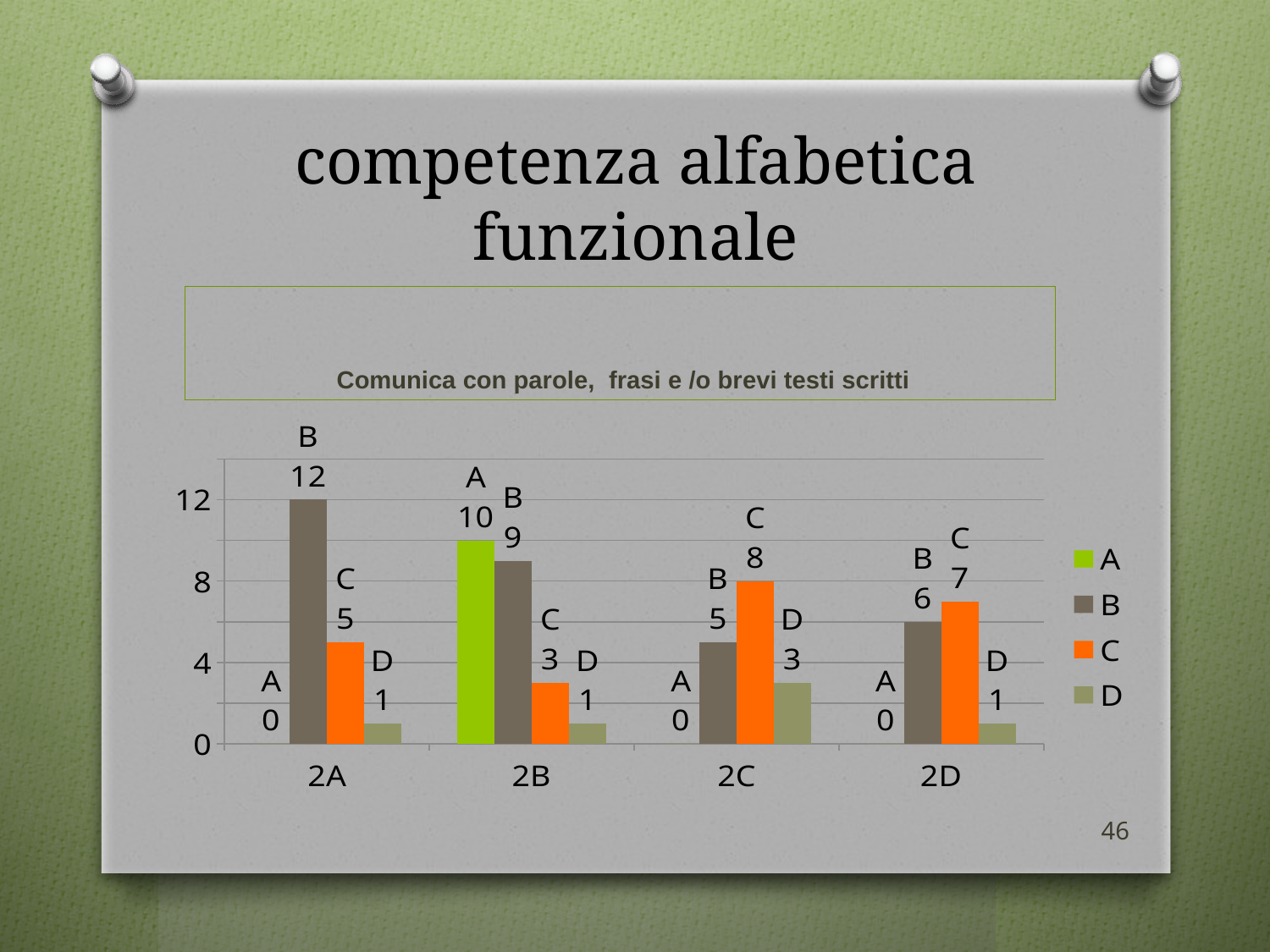
How many categories are shown on the x axis? 4 What is the difference between the values for series B and series C in category 2A? 7 How many series does the legend list? 4 Which category has the lowest value for series B? 2C Which is larger in category 2D: the value for series B or series C? C What is the value for series C in category 2C? 8 What is the value for series D in category 2D? 1 What is the value for series A in category 2B? 10 What is the text in the box above the chart? Comunica con parole, frasi e /o brevi testi scritti What is the value for series B in category 2A? 12 What kind of chart is shown on the slide? bar chart Which category has the highest value for series C? 2C